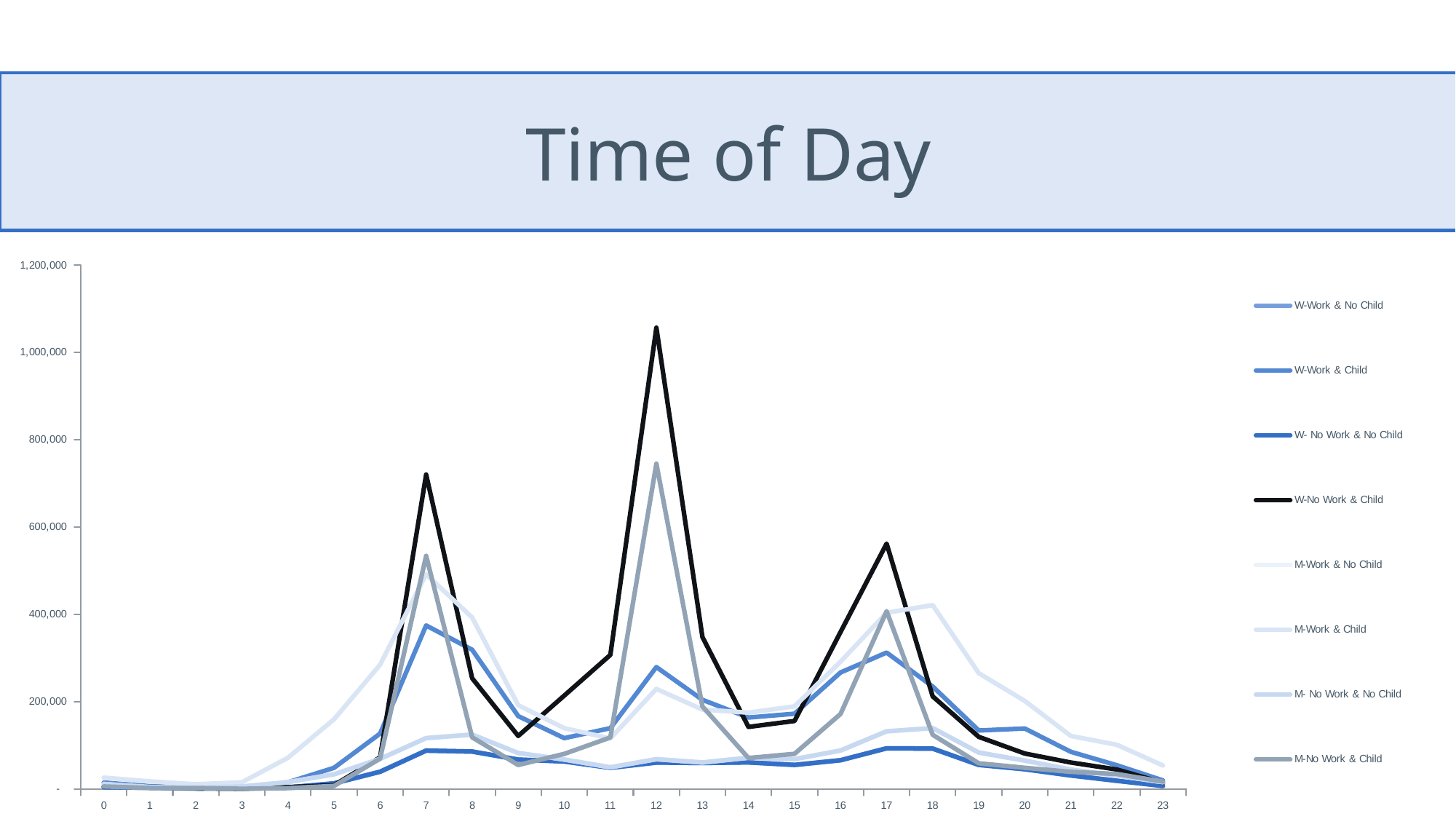
Between hour 12 and hour 14, does the W-No Work & Child series rise or fall? fall Is the value for M-No Work & Child at hour 12 greater or less than 600,000? greater At which hour does the W-No Work & Child series reach its highest value? 12 Is the value for W-No Work & Child at hour 7 greater or less than 600,000? greater What is the title of the slide containing the chart? Time of Day At hour 12, which series has the higher value, W-No Work & Child or M-No Work & Child? W-No Work & Child What kind of chart is shown on the slide? line chart How many series does the legend of the chart list? 8 How many hours (points) are shown along the x axis of the chart? 24 Is the value for W-No Work & Child at hour 12 greater or less than 1,000,000? greater Which series reaches the highest value anywhere on the chart? W-No Work & Child